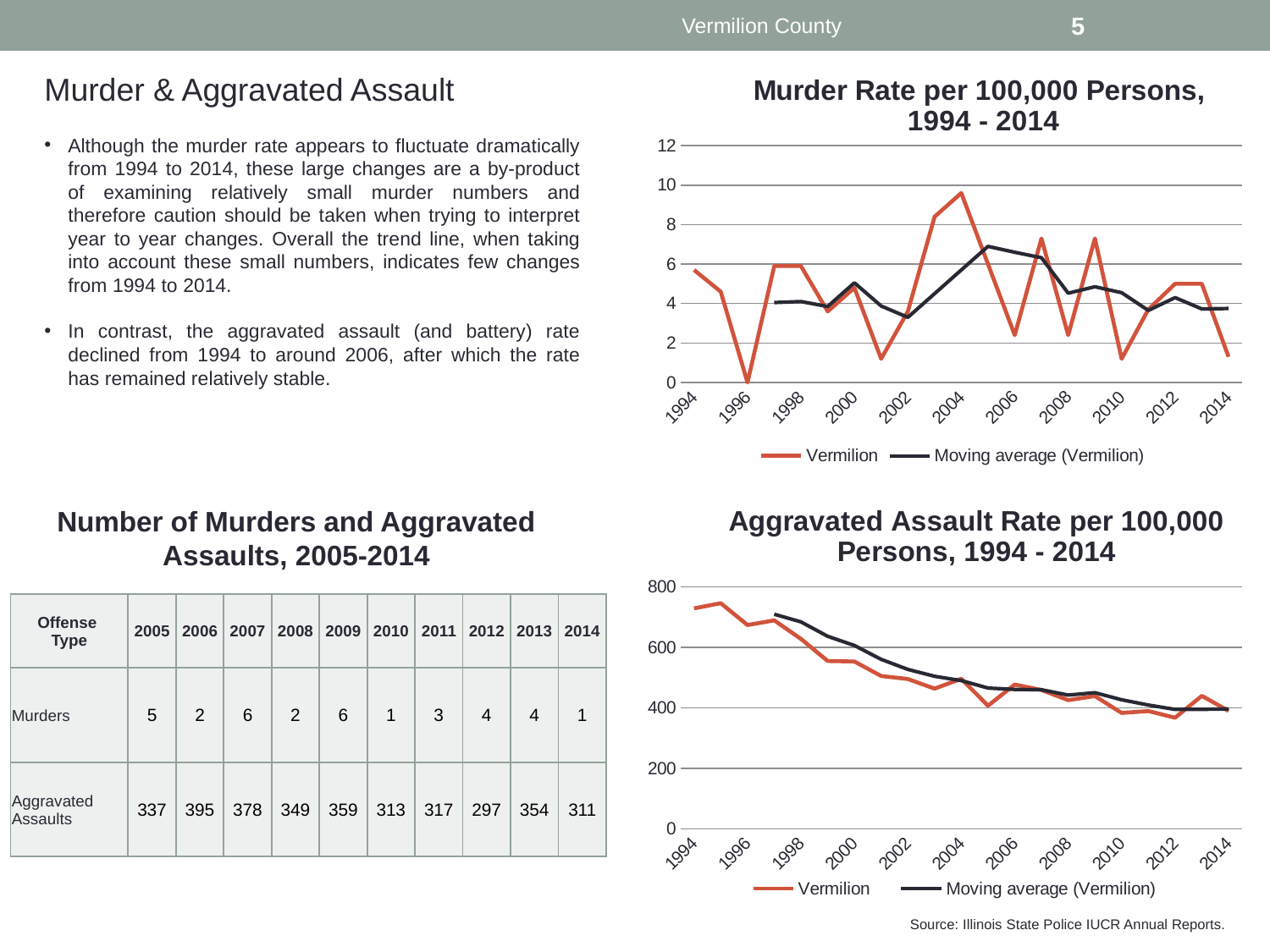
What kind of chart is the "Aggravated Assault Rate per 100,000 Persons, 1994 - 2014" chart? line chart In the "Aggravated Assault Rate per 100,000 Persons, 1994 - 2014" chart, do the Vermilion values generally rise or fall from 1994 to 2014? fall In the "Aggravated Assault Rate per 100,000 Persons, 1994 - 2014" chart, which is larger, the Vermilion value for 1994 or for 2014? 1994 How many series does the legend of the "Murder Rate per 100,000 Persons, 1994 - 2014" chart list? 2 In the "Murder Rate per 100,000 Persons, 1994 - 2014" chart, which series is drawn in black? Moving average (Vermilion) What kind of chart is the "Murder Rate per 100,000 Persons, 1994 - 2014" chart? line chart In the "Murder Rate per 100,000 Persons, 1994 - 2014" chart, which year has the highest Vermilion murder rate? 2004 In the "Murder Rate per 100,000 Persons, 1994 - 2014" chart, which year has the lowest Vermilion murder rate? 1996 In the "Murder Rate per 100,000 Persons, 1994 - 2014" chart, is the Vermilion value for 2014 greater or less than 2? less In the "Aggravated Assault Rate per 100,000 Persons, 1994 - 2014" chart, is the Vermilion value for 2012 greater or less than 400? less In the "Murder Rate per 100,000 Persons, 1994 - 2014" chart, is the Vermilion value for 2004 greater or less than 8? greater